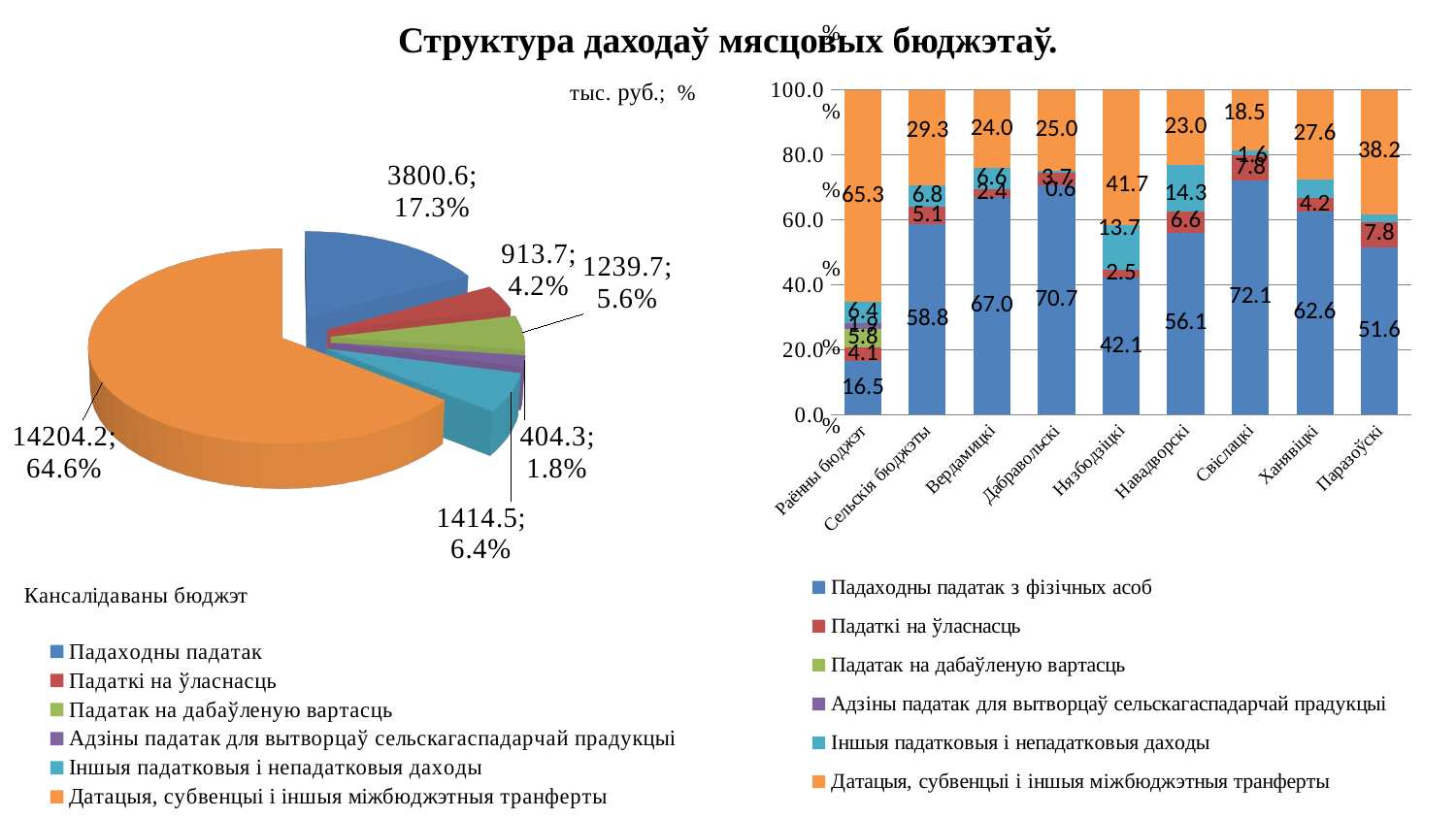
On the stacked bar chart on the right, what is the value of Датацыі, субвенцыі і іншыя міжбюджэтныя трансферты for Паразоўскі? 38.2 On the pie chart (Кансалідаваны бюджэт), which category has the smallest slice? Адзіны падатак для вытворцаў сельскагаспадарчай прадукцыі On the pie chart (Кансалідаваны бюджэт), what value is shown for Іншыя падатковыя і непадатковыя даходы? 1414.5; 6.4% On the stacked bar chart on the right, which category has the lowest value of Падаходны падатак з фізічных асоб? Раённы бюджэт On the pie chart (Кансалідаваны бюджэт), how many slices are there? 6 On the stacked bar chart on the right, how many series does the legend list? 6 On the stacked bar chart on the right, what is the difference between the Падаходны падатак з фізічных асоб values for Дабравольскі and Нязбодзіцкі? 28.6 On the pie chart (Кансалідаваны бюджэт), what share of the pie does Датацыі, субвенцыі і іншыя міжбюджэтныя трансферты have? 64.6% On the stacked bar chart on the right, how many categories are shown on the x axis? 9 On the stacked bar chart on the right, which category has the highest value of Падаходны падатак з фізічных асоб? Свіслацкі On the pie chart (Кансалідаваны бюджэт), what value and share are shown for Падаходны падатак? 3800.6; 17.3% On the stacked bar chart on the right, what is the value of Падаходны падатак з фізічных асоб for Свіслацкі? 72.1